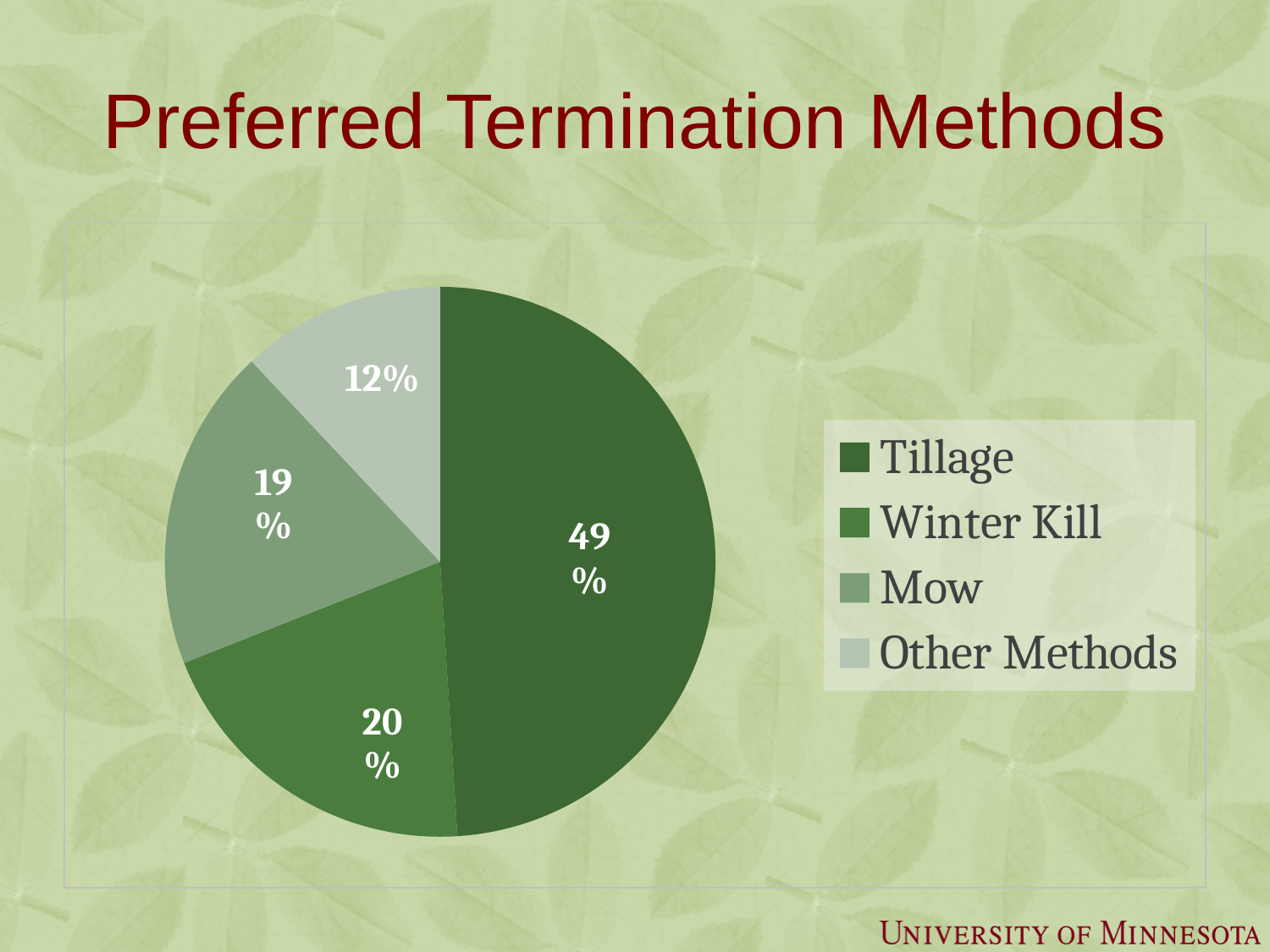
What is the difference in percentage points between the Mow share and the Other Methods share? 7 What share of the pie does Other Methods account for? 12% How many categories does the pie chart show? 4 What share of the pie does Mow account for? 19% What share of the pie does Tillage account for? 49% Which termination method has the smallest share of the pie? Other Methods What is the difference in percentage points between the Tillage share and the Winter Kill share? 29 Which termination method has the largest share of the pie? Tillage What is the title of the slide containing the chart? Preferred Termination Methods What share of the pie does Winter Kill account for? 20% What kind of chart is shown on the slide? Pie chart Which has a larger share, Tillage or Mow? Tillage